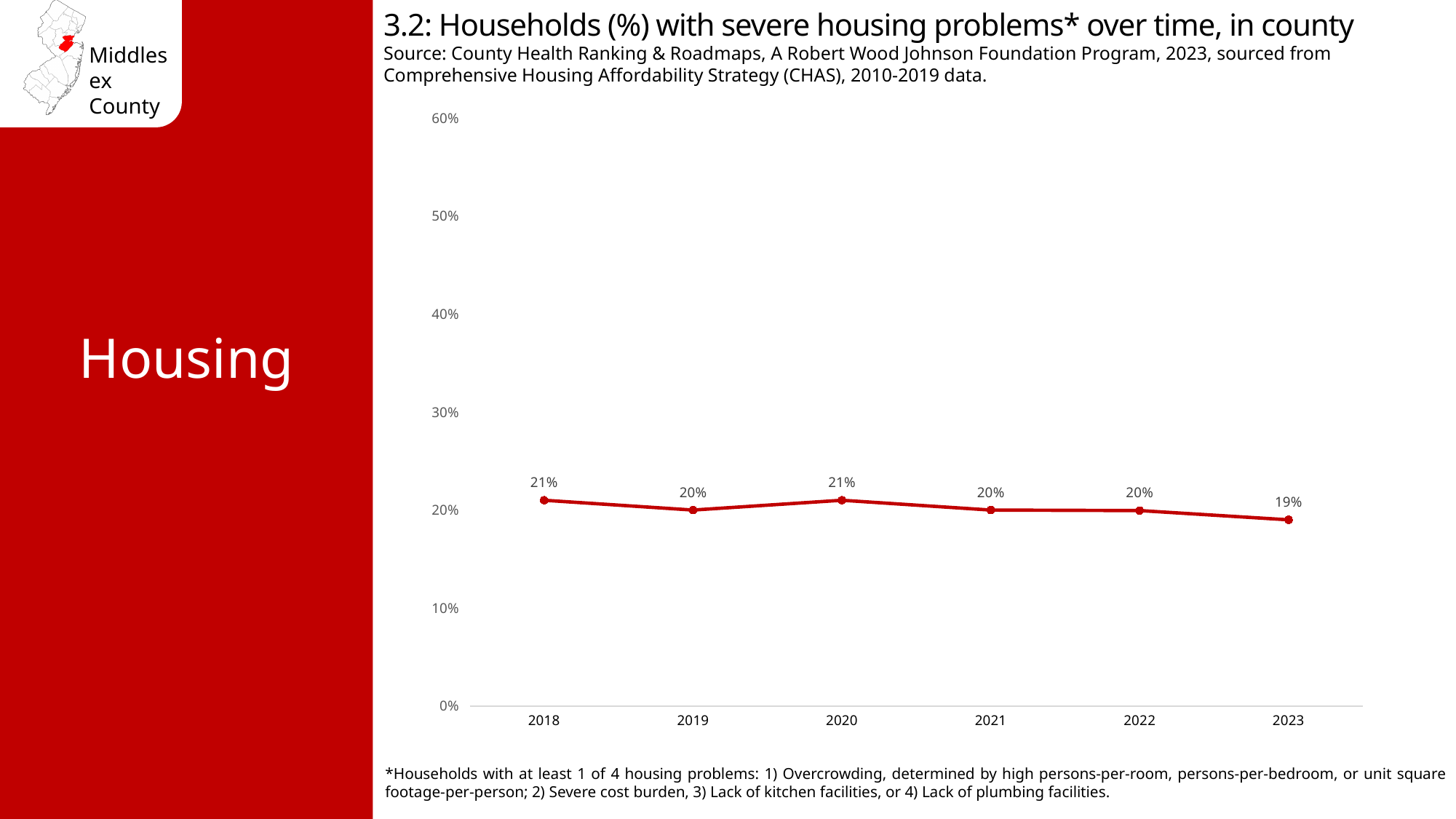
What is the title of the chart? 3.2: Households (%) with severe housing problems* over time, in county What is the value plotted for 2023? 19% Which is larger, the value for 2020 or the value for 2023? 2020 Which year has the lowest percentage of households with severe housing problems? 2023 What is the value plotted for 2021? 20% What type of chart is shown on the slide? line chart How many years are plotted on the x axis? 6 Overall, do the values rise or fall from 2018 to 2023? fall What percentage of households had severe housing problems in 2018? 21% What is the difference between the 2018 value and the 2023 value? 2% What is the value plotted for 2020? 21% Is the value for 2023 greater or less than 30%? less